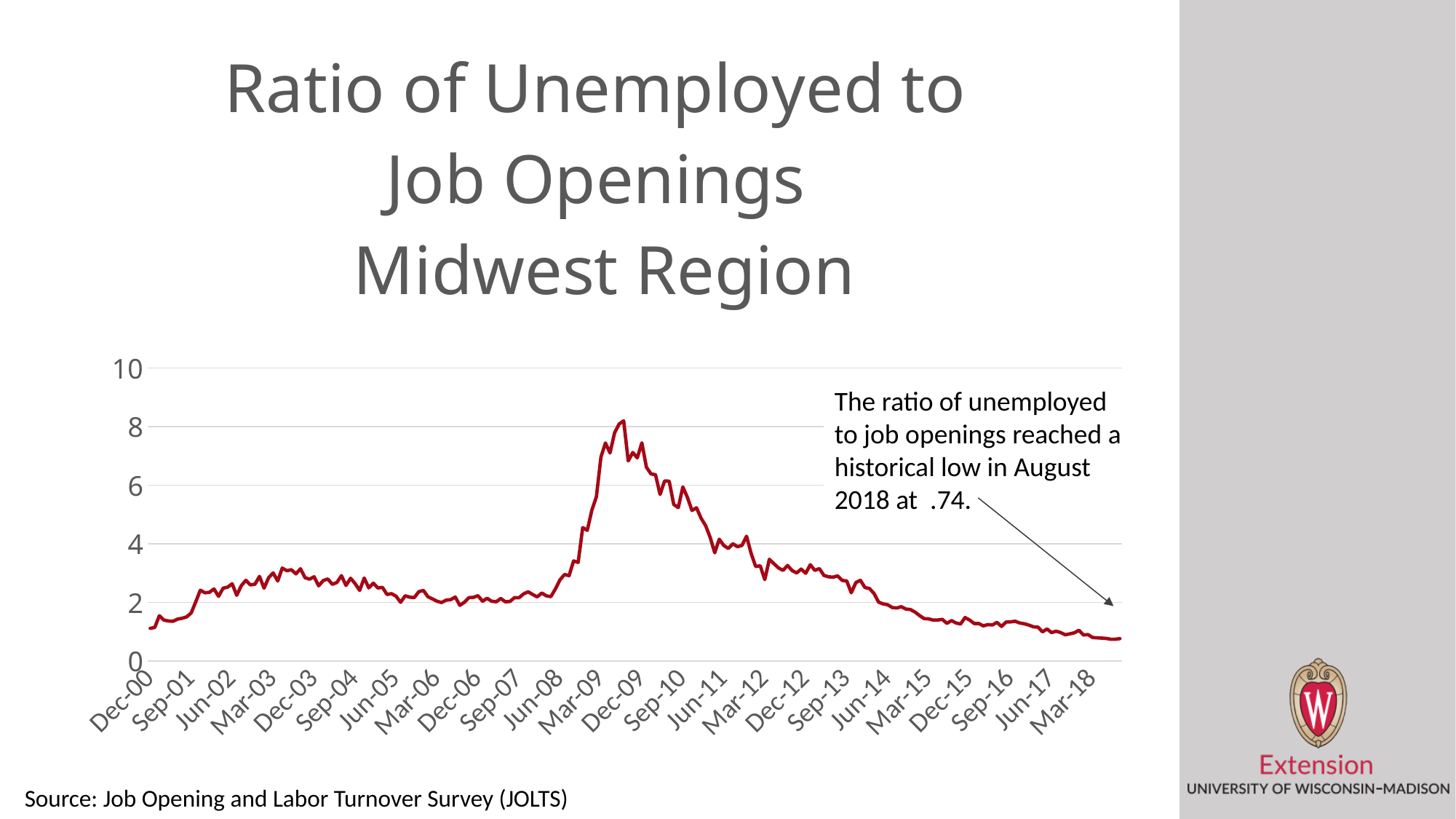
In which month and year did the ratio reach its historical low, according to the annotation? August 2018 Is the value of the ratio at Mar-03 greater or less than 2? greater Around which x-axis label does the ratio reach its highest point? Dec-09 According to the annotation, what was the ratio of unemployed to job openings in August 2018? .74 Is the peak value of the ratio around Dec-09 greater or less than 6? greater Which is larger, the ratio at Dec-09 or the ratio at Mar-18? Dec-09 Is the value of the ratio at Mar-18 greater or less than 2? less Does the ratio generally rise or fall between Dec-09 and Mar-18? fall What is the title of the chart? Ratio of Unemployed to Job Openings Midwest Region What is the highest value shown on the y-axis? 10 What kind of chart is shown on the slide? line chart